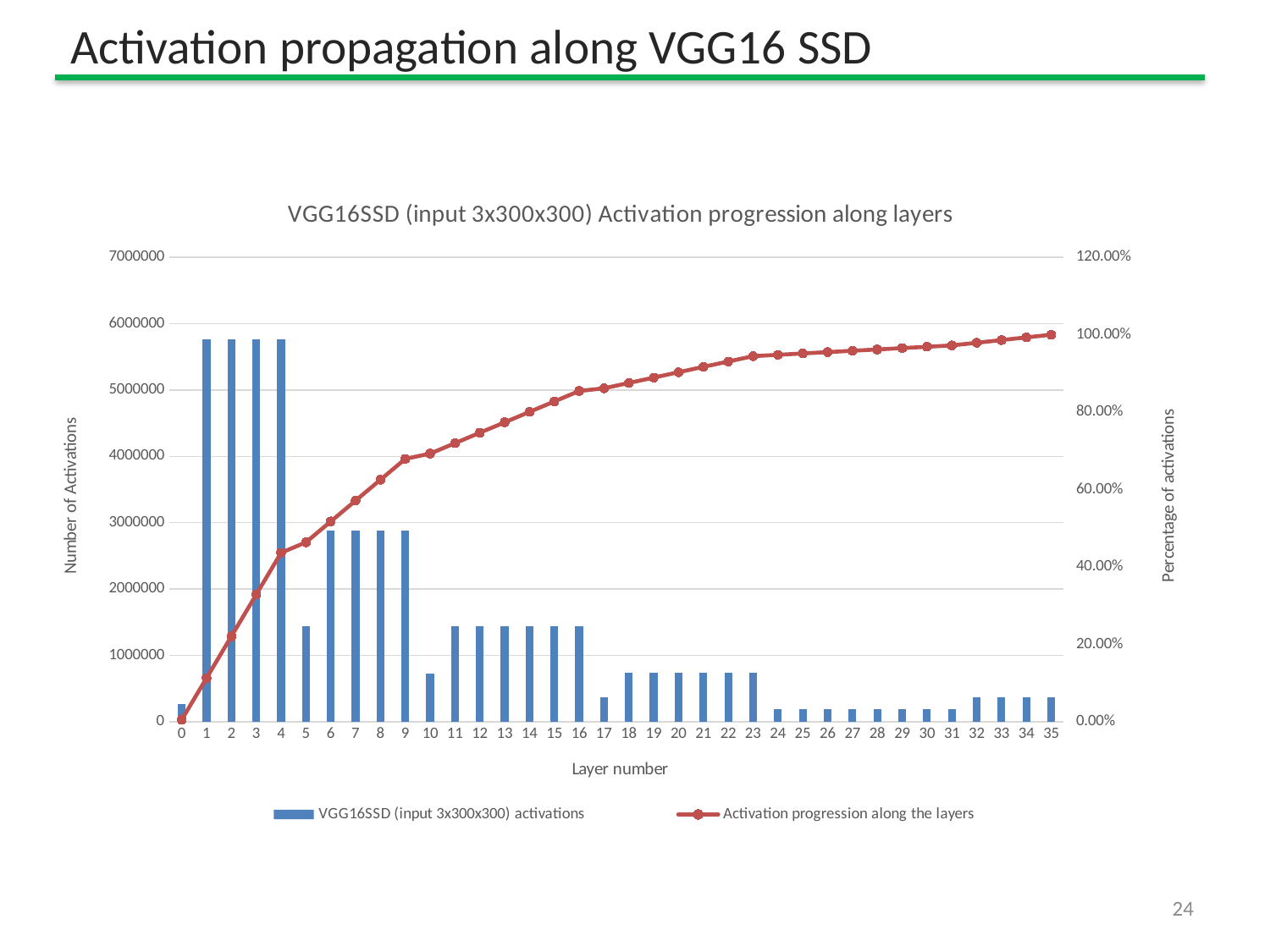
Is the number of activations for layer 24 greater or less than 1000000? less Is the activation progression percentage at layer 35 greater or less than 80.00%? greater How many layer numbers are shown on the x axis? 36 What kind of chart is this? A combined bar and line chart Does the 'Activation progression along the layers' line rise or fall as the layer number increases? Rises Is the number of activations for layer 6 greater or less than 3000000? less How many series does the legend list? 2 What is the title of the chart? VGG16SSD (input 3x300x300) Activation progression along layers Which layer has more activations, layer 1 or layer 6? Layer 1 What is the label of the left vertical axis? Number of Activations